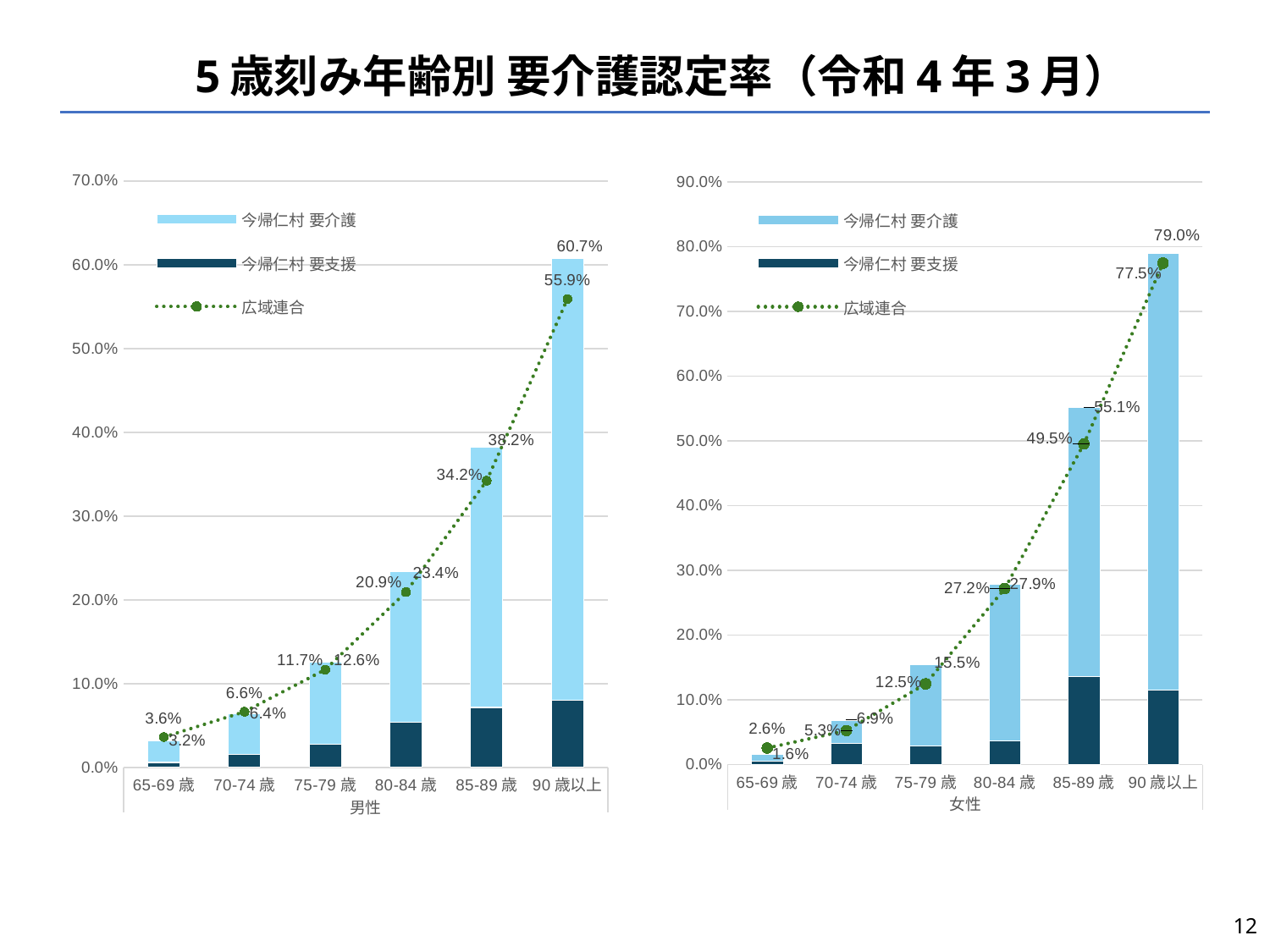
Do the total stacked bar values in the 女性 chart on the right rise or fall as age increases along the x axis? rise In the 女性 chart on the right, which is larger for 85-89歳: the total stacked bar value or the 広域連合 value? the total stacked bar value In the 女性 chart on the right, which age group has the highest total stacked bar value? 90歳以上 In the 男性 chart on the left, is the 今帰仁村 要支援 value for 90歳以上 greater or less than 10.0%? less In the 女性 chart on the right, what is the 広域連合 value for 90歳以上? 77.5% How many series does the legend of the 男性 chart on the left list? 3 How many age groups are shown on the x axis of the 女性 chart on the right? 6 In the 男性 chart on the left, what is the 広域連合 value for 80-84歳? 20.9% In the 男性 chart on the left, what is the difference between the total stacked bar value and the 広域連合 value for 90歳以上? 4.8% In the 女性 chart on the right, what is the total stacked bar value for 85-89歳? 55.1% In the 男性 chart on the left, which age group has the lowest 広域連合 value? 65-69歳 In the 男性 chart on the left, what is the total stacked bar value for 90歳以上? 60.7%